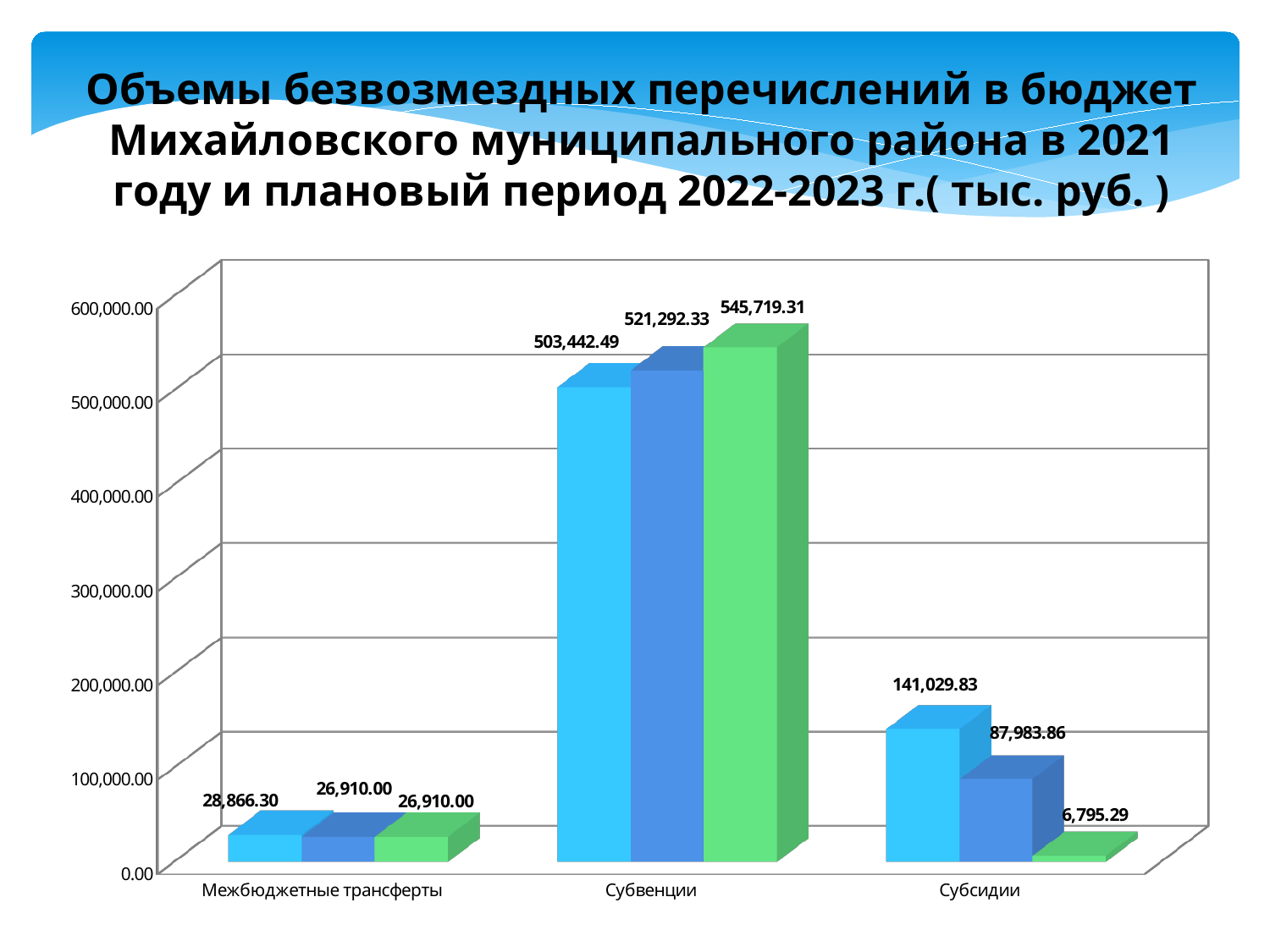
What is the value of the dark blue (second) bar for Межбюджетные трансферты? 26,910.00 What is the value of the light blue (first) bar for Субсидии? 141,029.83 What is the value of the green (third) bar for Субсидии? 6,795.29 Is the value of the dark blue bar for Субсидии greater or less than 100,000.00? less Which category has the highest values on the chart? Субвенции What is the difference between the light blue bar and the dark blue bar for Субсидии? 53,045.97 Which bar has the lowest value on the chart? The green bar for Субсидии (6,795.29) How many categories are shown on the x axis? 3 What is the difference between the green bar and the light blue bar for Субвенции? 42,276.82 Which is larger for Субвенции: the dark blue bar or the green bar? The green bar What is the value of the light blue (first) bar for Субвенции? 503,442.49 What type of chart is shown on the slide? Bar chart